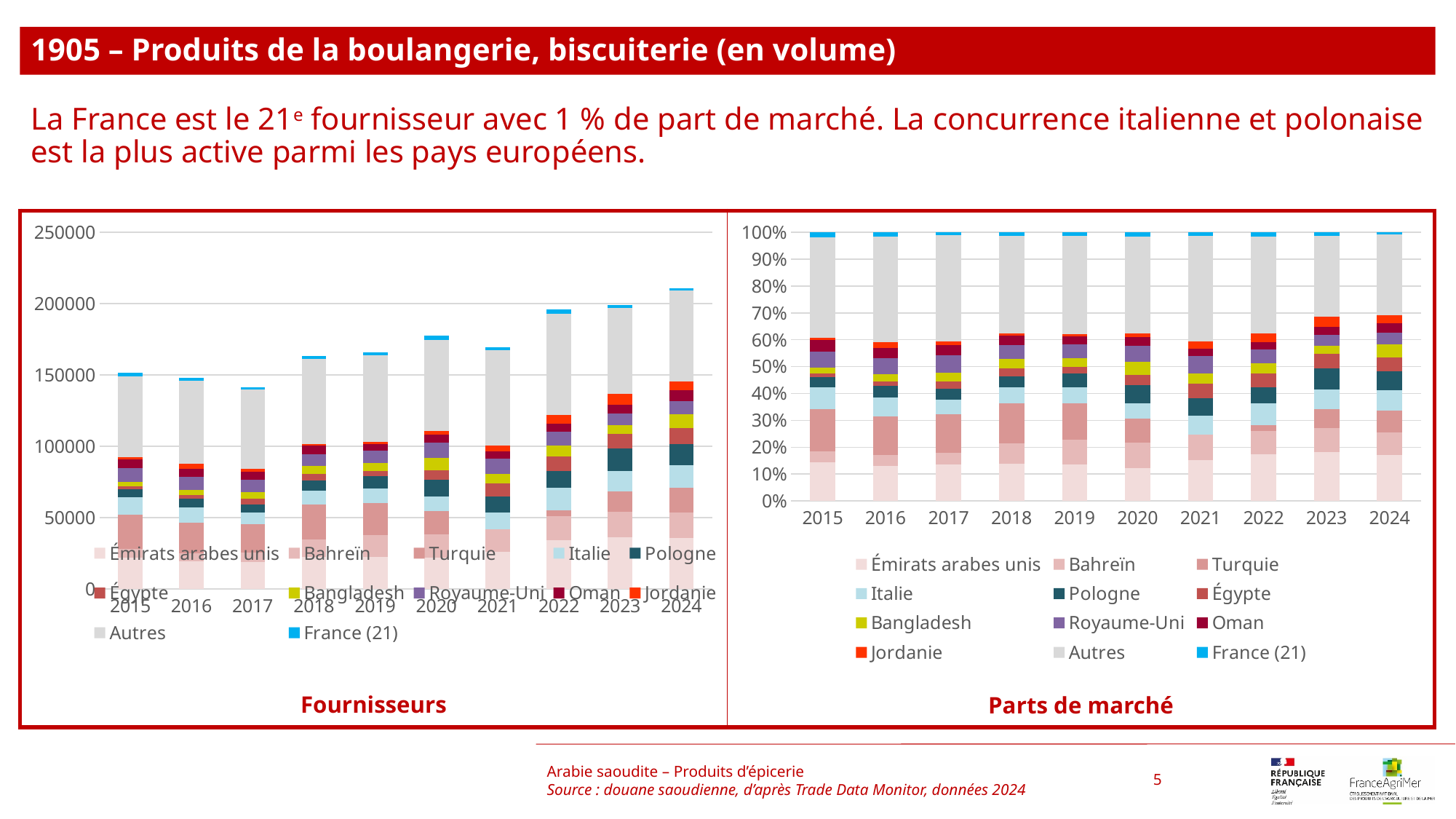
In the 'Fournisseurs' chart, which total is larger, 2015 or 2024? 2024 In the 'Fournisseurs' chart, is the total for 2018 greater or less than 150000? greater In the 'Fournisseurs' chart, is the total for 2024 greater or less than 200000? greater In the 'Parts de marché' chart, how many series does the legend list? 12 What kind of chart is the 'Fournisseurs' chart on the left? stacked bar chart In the 'Fournisseurs' chart, which year has the lowest total bar? 2017 In the 'Fournisseurs' chart, do the total bars generally rise or fall from 2015 to 2024? rise What kind of chart is the 'Parts de marché' chart on the right? 100% stacked bar chart In the 'Fournisseurs' chart, how many years are shown on the x axis? 10 In the 'Fournisseurs' chart, is the total for 2017 greater or less than 150000? less In the 'Fournisseurs' chart, which year has the highest total bar? 2024 In the 'Parts de marché' chart, which series is listed last in the legend? France (21)